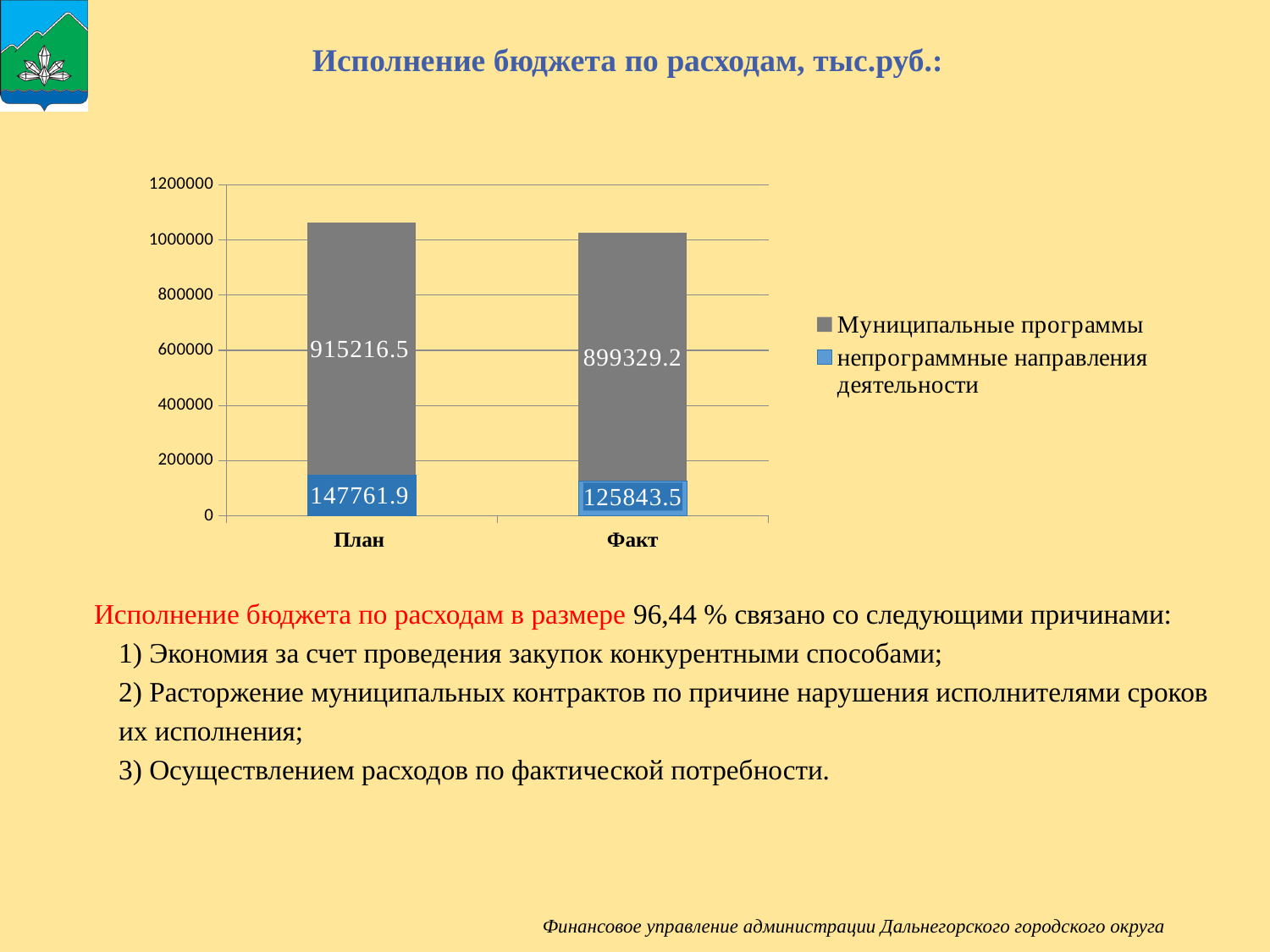
How many series does the legend list? 2 Which is larger for Муниципальные программы: План or Факт? План What is the value for Муниципальные программы in the План bar? 915216.5 What is the value for непрограммные направления деятельности in the План bar? 147761.9 What is the total of the stacked План bar? 1062978.4 What is the title of the chart? Исполнение бюджета по расходам, тыс.руб.: What kind of chart is shown on the slide? Stacked bar chart What is the total of the stacked Факт bar? 1025172.7 What is the difference between the План and Факт values for непрограммные направления деятельности? 21918.4 What is the value for Муниципальные программы in the Факт bar? 899329.2 What is the value for непрограммные направления деятельности in the Факт bar? 125843.5 What is the difference between the План and Факт values for Муниципальные программы? 15887.3